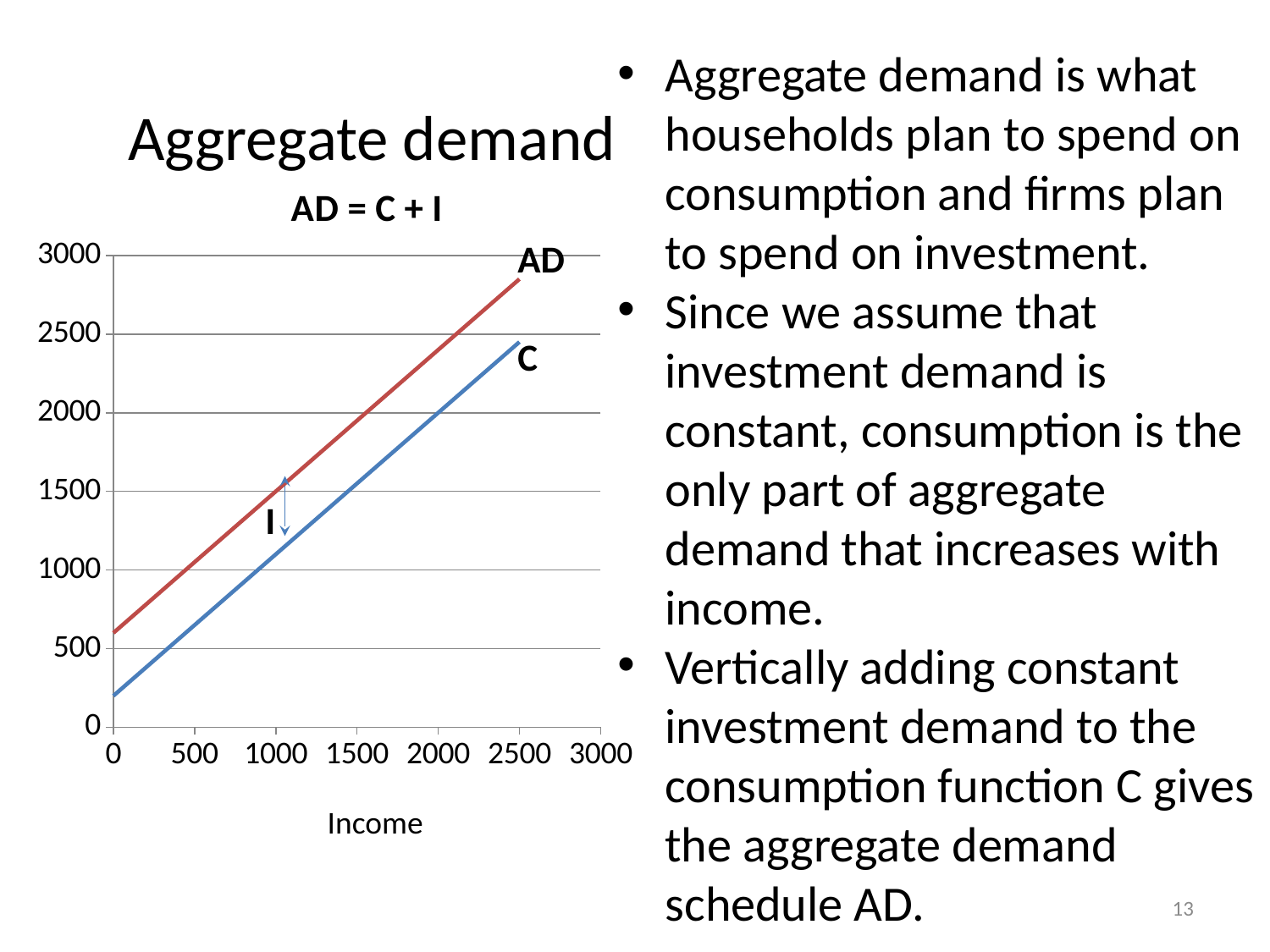
What is the title of the chart? AD = C + I Is the value of the AD line at income 2500 greater or less than 2500? greater Is the value of the C line at income 0 greater or less than 500? less What kind of chart is shown on the slide? line chart What is the highest value shown on the y axis of the chart? 3000 What is the label of the x axis of the chart? Income Do the AD and C lines rise or fall as income increases? rise Is the value of the C line at income 500 greater or less than 500? greater Which line lies higher on the chart, AD or C? AD How many lines are plotted on the chart? 2